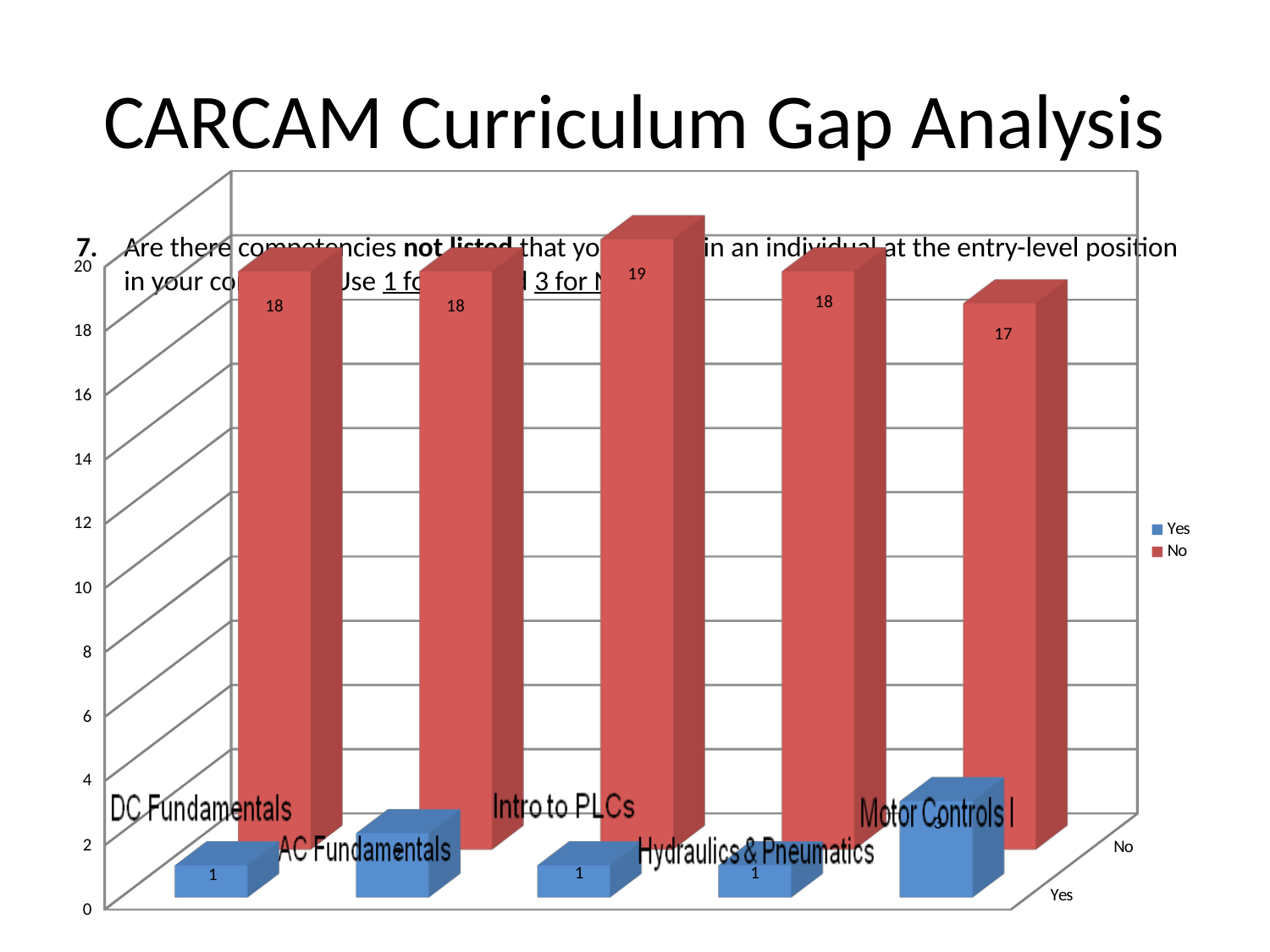
What is the No value for Intro to PLCs? 19 What is the No value for Hydraulics & Pneumatics? 18 Which category has the lowest No value? Motor Controls I What kind of chart is shown on the slide? Bar chart Which is larger, the No value for Intro to PLCs or the No value for Motor Controls I? Intro to PLCs What is the total of the Yes and No values for DC Fundamentals? 19 What is the No value for Motor Controls I? 17 Which category has the highest No value? Intro to PLCs What is the difference between the No values for Intro to PLCs and Motor Controls I? 2 How many series does the legend list? 2 What is the Yes value for DC Fundamentals? 1 How many categories are shown on the chart? 5